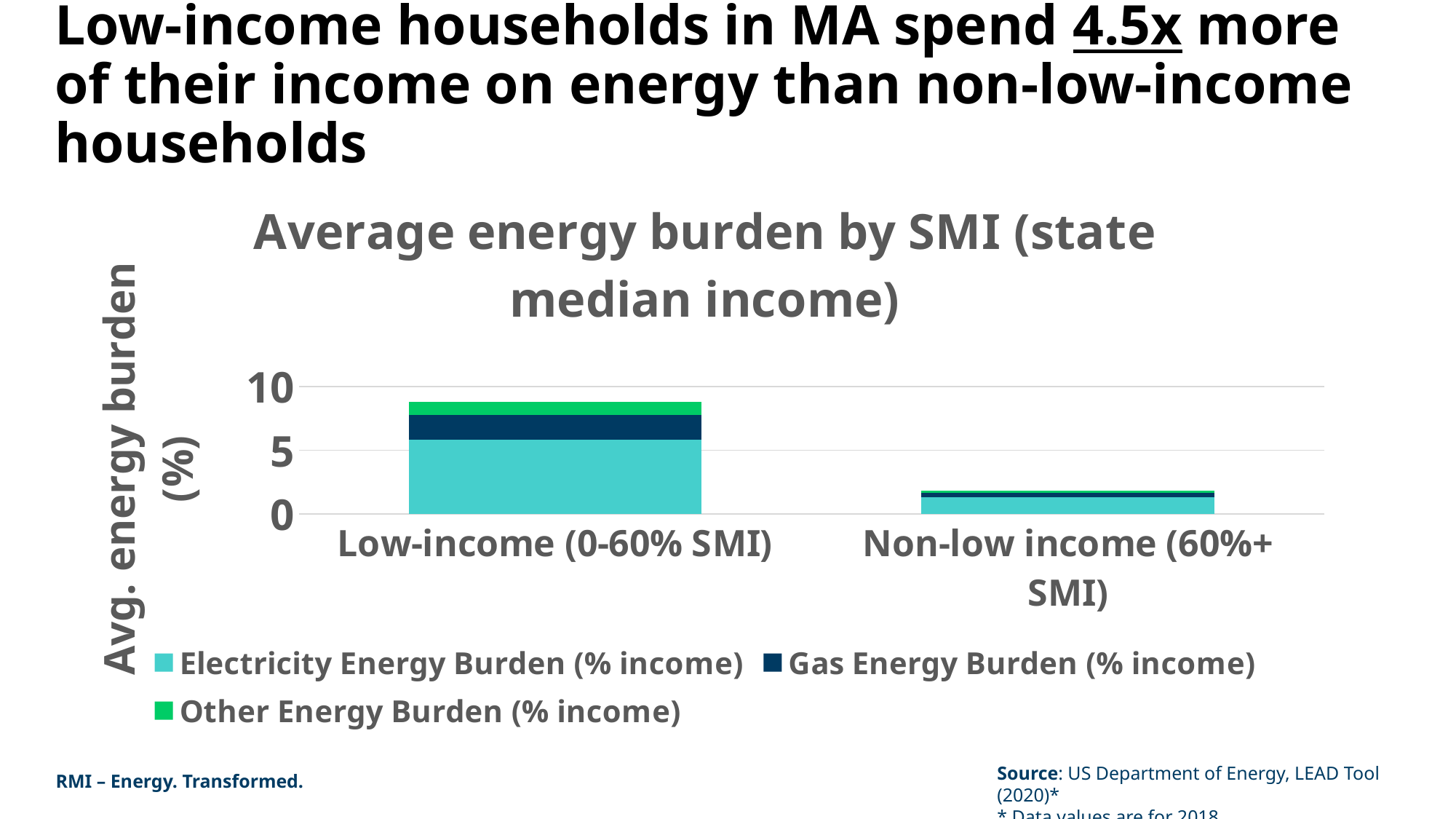
Is the total energy burden for Low-income (0-60% SMI) greater or less than 5? greater What is the title of the chart? Average energy burden by SMI (state median income) How many categories are shown on the x axis? 2 Is the total energy burden for Low-income (0-60% SMI) greater or less than 10? less Which series makes up the largest part of the Low-income (0-60% SMI) bar? Electricity Energy Burden (% income) Which is larger, the Electricity Energy Burden for Low-income (0-60% SMI) or for Non-low income (60%+ SMI)? Low-income (0-60% SMI) How many series does the legend list? 3 What is the label of the y axis? Avg. energy burden (%) Which category has the highest total energy burden? Low-income (0-60% SMI) What kind of chart is shown on the slide? stacked bar chart Which category has the lowest total energy burden? Non-low income (60%+ SMI) Is the total energy burden for Non-low income (60%+ SMI) greater or less than 5? less